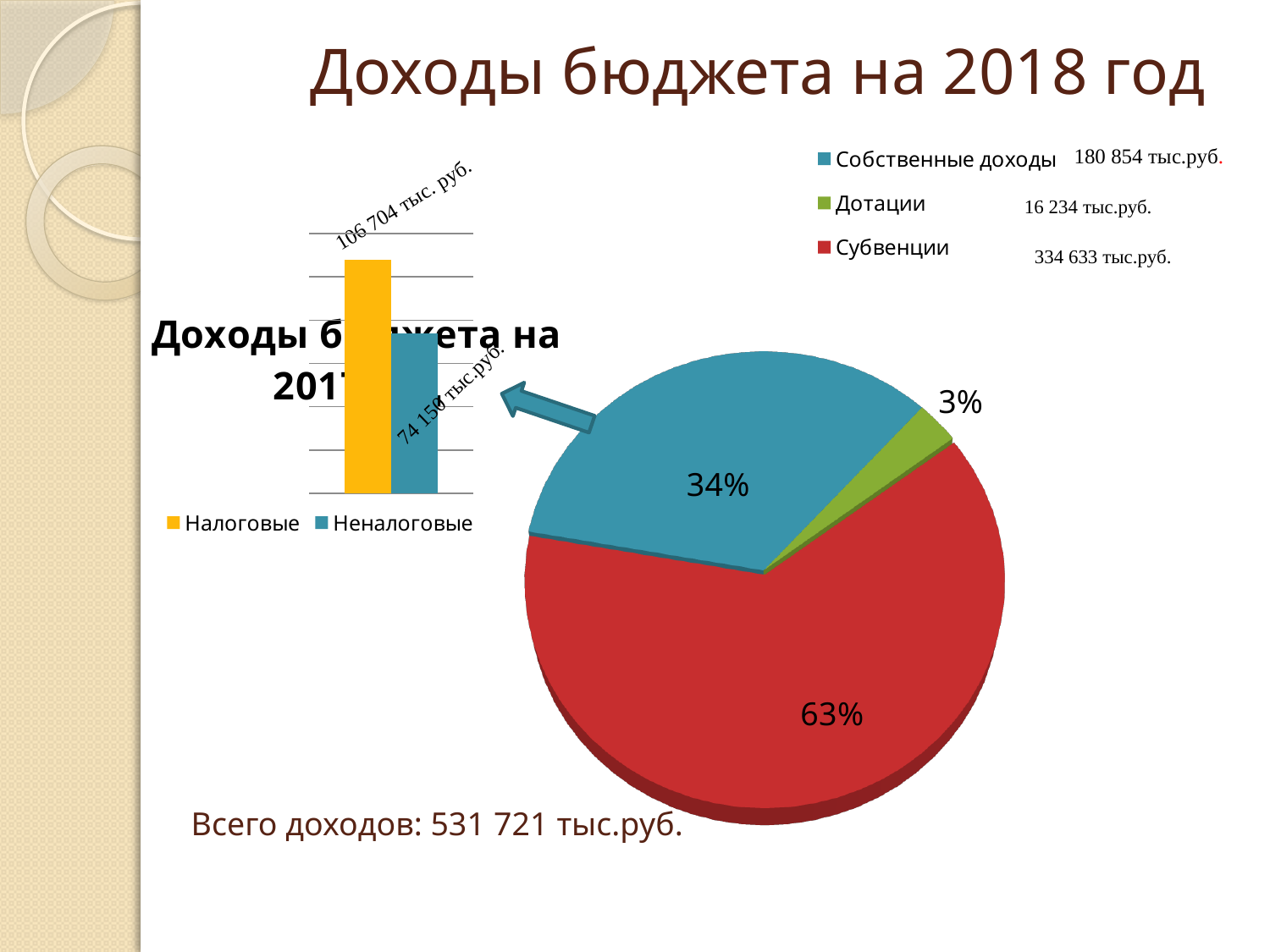
What kind of chart is the chart on the left? Bar chart How many series does the legend of the bar chart on the left list? 2 In the pie chart, what colour is the Дотации slice? Green In the pie chart, what share does Субвенции have? 63% In the bar chart on the left, what is the value for Налоговые? 106 704 тыс. руб. In the pie chart, what share does Собственные доходы have? 34% In the pie chart, what share does Дотации have? 3% In the pie chart, which category has the largest slice? Субвенции In the pie chart, which category has the smallest slice? Дотации In the pie chart, which is larger: Собственные доходы or Субвенции? Субвенции In the bar chart on the left, which category is higher: Налоговые or Неналоговые? Налоговые In the pie chart, how many slices are there? 3